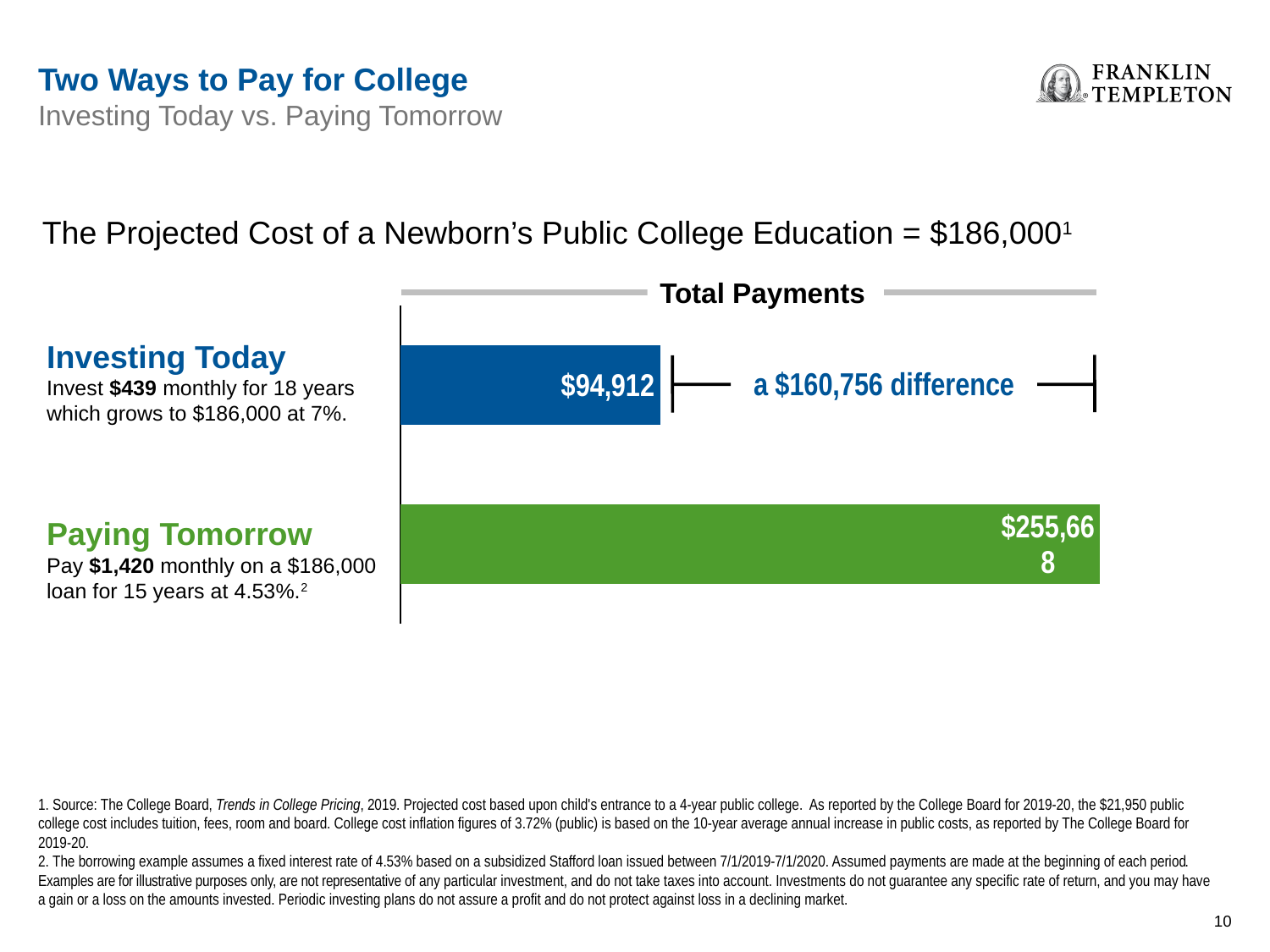
How many bars are plotted in the chart? 2 What colour is the bar for Paying Tomorrow? green What kind of chart is shown on the slide? bar chart Is the total payment for Investing Today larger or smaller than the total payment for Paying Tomorrow? smaller What is the projected cost of a newborn's public college education stated on the slide? $186,000 What is the difference in total payments between Paying Tomorrow and Investing Today? $160,756 What is the total payment value shown for Paying Tomorrow? $255,668 What is the title of the chart? Total Payments Which option has the lower total payments? Investing Today What is the total payment value shown for Investing Today? $94,912 Which option has the higher total payments? Paying Tomorrow